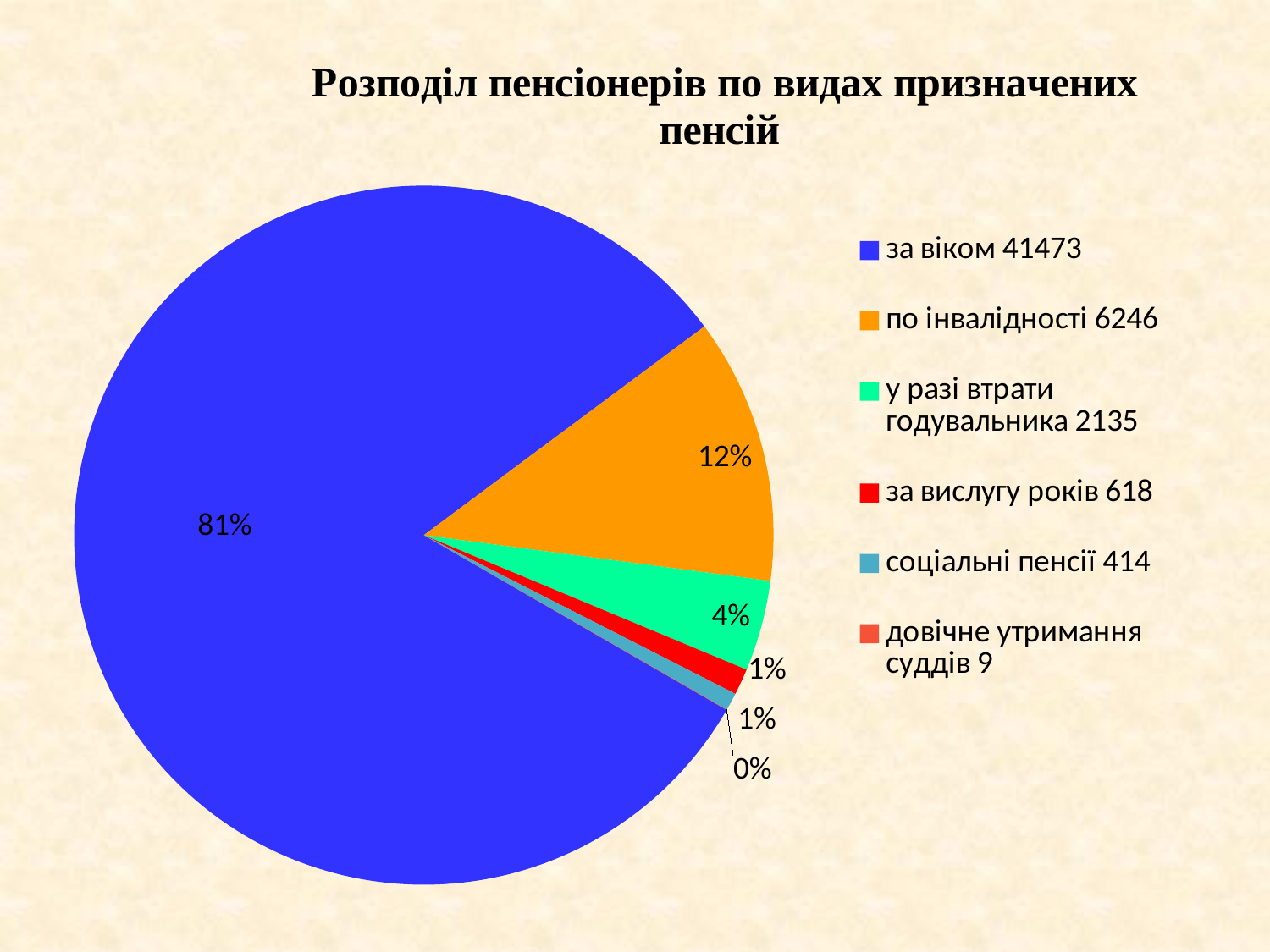
What is the difference between the number for 'за віком' and the number for 'по інвалідності'? 35227 What share of the pie does the 'за віком' slice represent? 81% Which category has the smallest slice of the pie? довічне утримання суддів What share of the pie does the 'у разі втрати годувальника' slice represent? 4% What kind of chart is shown on the slide? pie chart What share of the pie does the 'по інвалідності' slice represent? 12% Which category has the largest slice of the pie? за віком According to the legend, how many pensioners are in the 'за вислугу років' category? 618 Which is larger: the number for 'по інвалідності' or for 'у разі втрати годувальника'? по інвалідності According to the legend, how many pensioners are in the 'соціальні пенсії' category? 414 How many slices does the pie chart have? 6